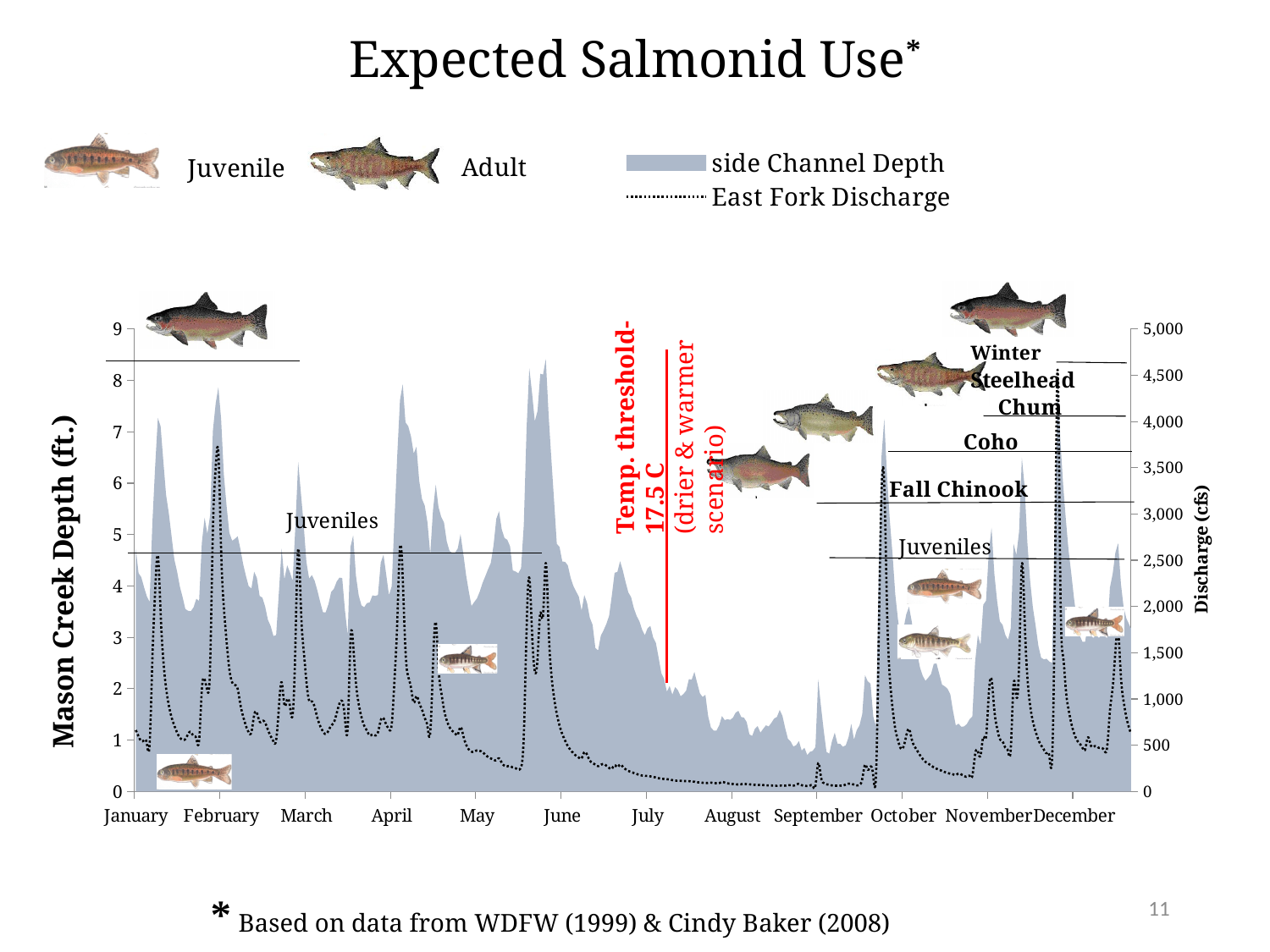
Is the peak East Fork Discharge in December greater or less than 3,500 cfs? greater How many months are labelled along the x axis? 12 Which series is drawn as a dotted line? East Fork Discharge How many series does the legend list? 2 Does the side Channel Depth generally rise or fall from June to August? fall What is the maximum value shown on the right Discharge axis? 5,000 Is the East Fork Discharge in August greater or less than 500 cfs? less What is the title of the left vertical axis? Mason Creek Depth (ft.) Is the side Channel Depth in August greater or less than 3 ft? less What kind of chart is shown on the slide? Area chart with a line series